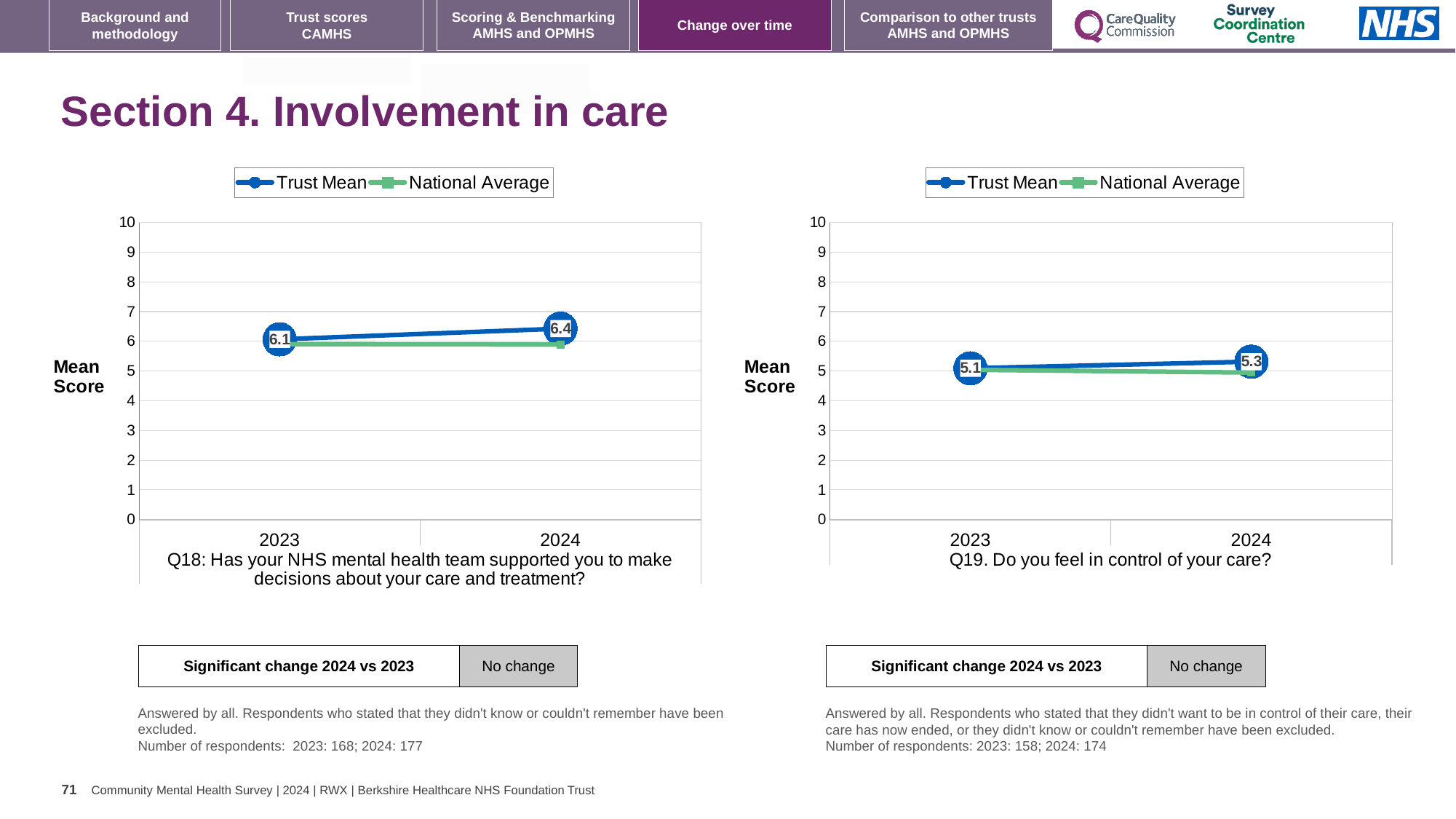
In the Q18 chart (left), what is the Trust Mean score for 2024? 6.4 How many years are plotted on the x axis of the Q19 chart (right)? 2 In the Q18 chart (left), does the Trust Mean rise or fall from 2023 to 2024? rise In the Q18 chart (left), which series has the higher value in 2024, Trust Mean or National Average? Trust Mean In the Q19 chart (right), what is the difference between the Trust Mean in 2024 and 2023? 0.2 In the Q18 chart (left), what is the Trust Mean score for 2023? 6.1 In the Q19 chart (right), is the National Average for 2024 greater or less than 6? less In the Q19 chart (right), what is the Trust Mean score for 2023? 5.1 What kind of chart is the Q19 chart (right)? line chart In the Q18 chart (left), by how much did the Trust Mean change from 2023 to 2024? 0.3 How many series does the legend of the Q18 chart (left) list? 2 In the Q19 chart (right), what is the Trust Mean score for 2024? 5.3